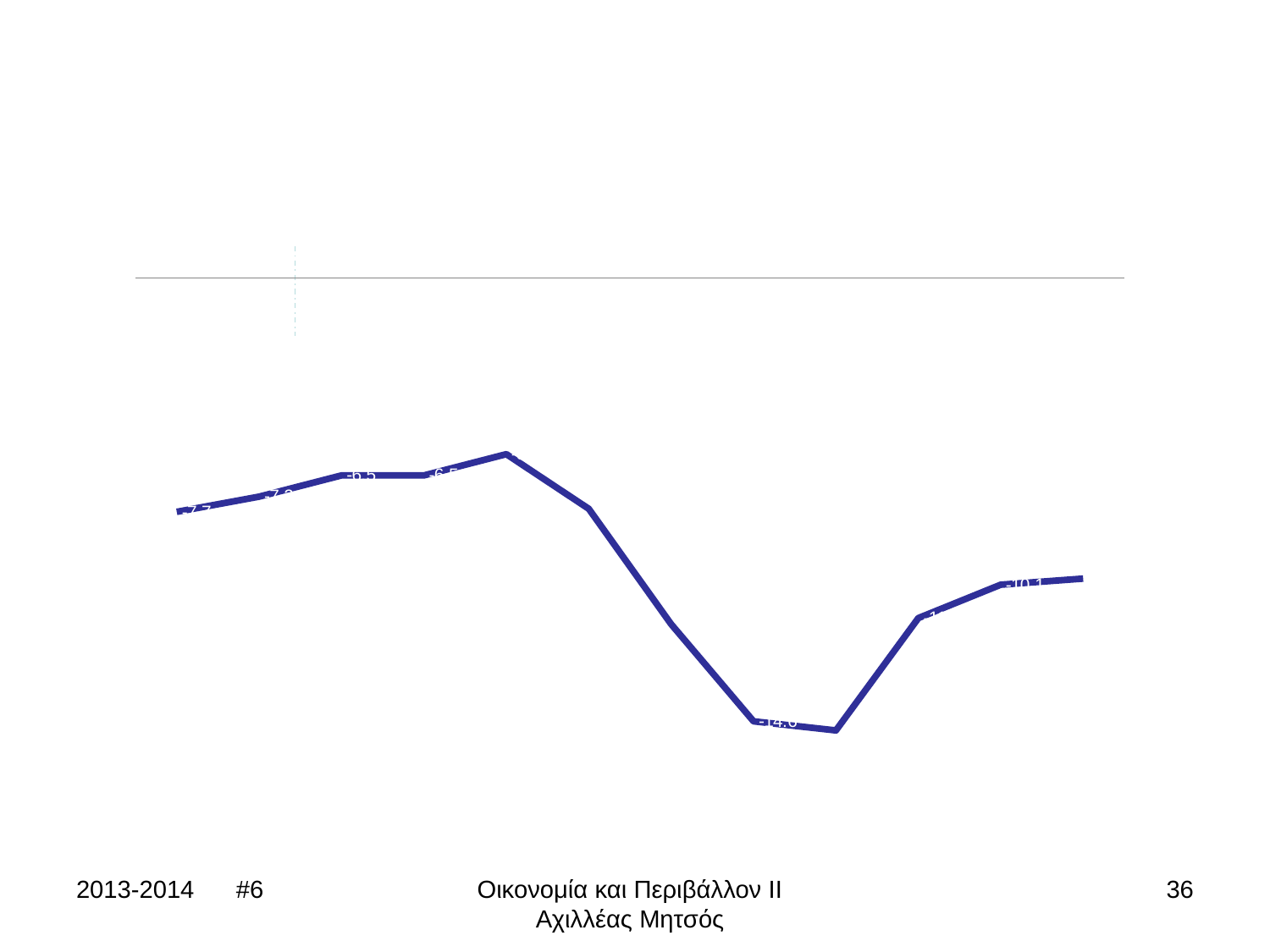
What colour is the line plotted on the chart? blue What kind of chart is shown on the slide? line chart Does the line end higher or lower than where it starts? lower How many data points does the line on the chart have? 12